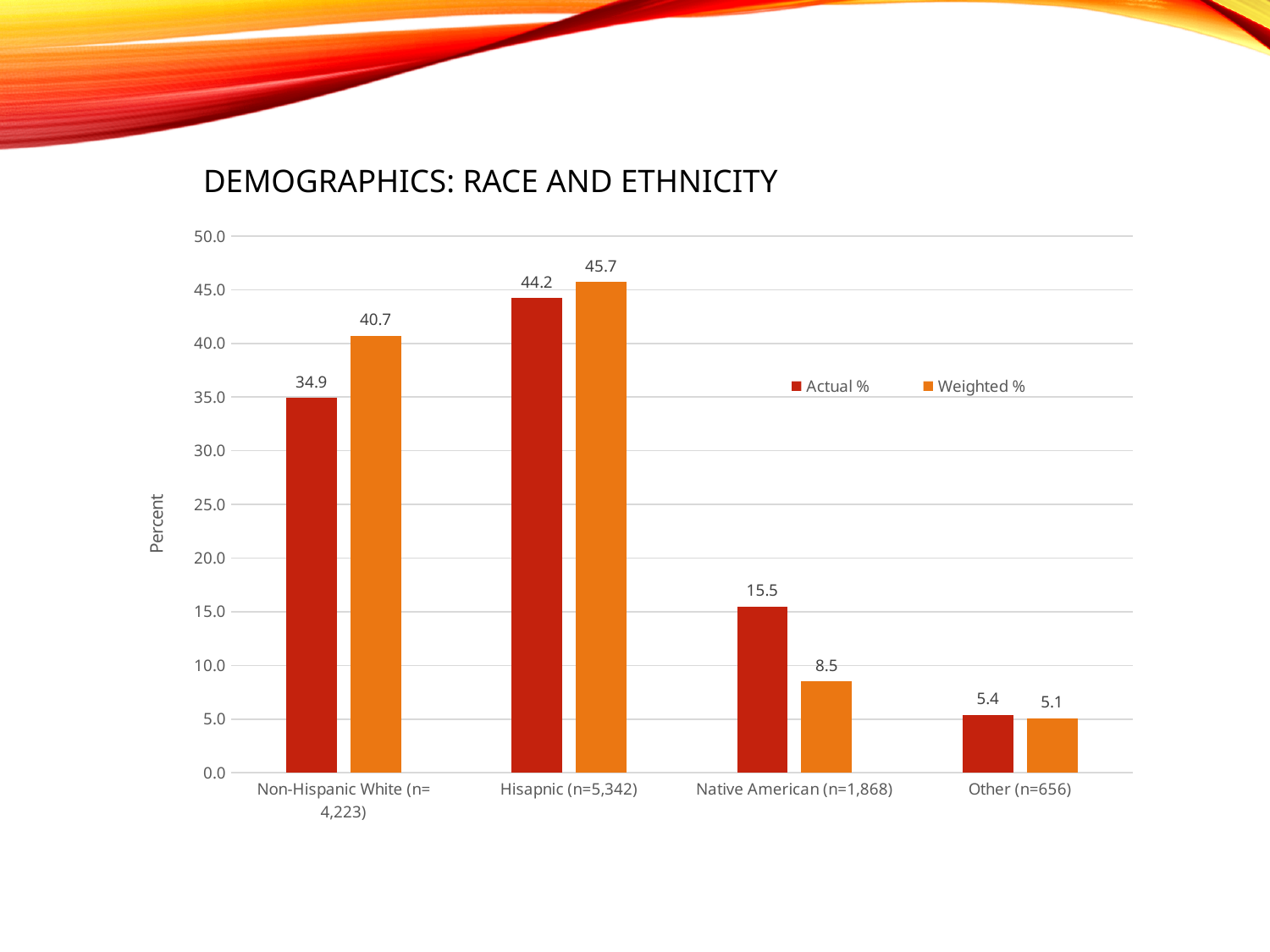
What is the Actual % value for Non-Hispanic White (n= 4,223)? 34.9 What is the difference between the Weighted % and Actual % values for Non-Hispanic White (n= 4,223)? 5.8 What is the label on the vertical axis of the chart? Percent What is the Weighted % value for Native American (n=1,868)? 8.5 How many categories are shown on the x axis? 4 What kind of chart is shown on the slide? bar chart Which is larger for Other (n=656): the Actual % value or the Weighted % value? Actual % Which category has the highest Actual % value? Hisapnic (n=5,342) How many series does the legend list? 2 What is the difference between the Actual % and Weighted % values for Native American (n=1,868)? 7.0 Which category has the lowest Weighted % value? Other (n=656) What is the Weighted % value for Hisapnic (n=5,342)? 45.7